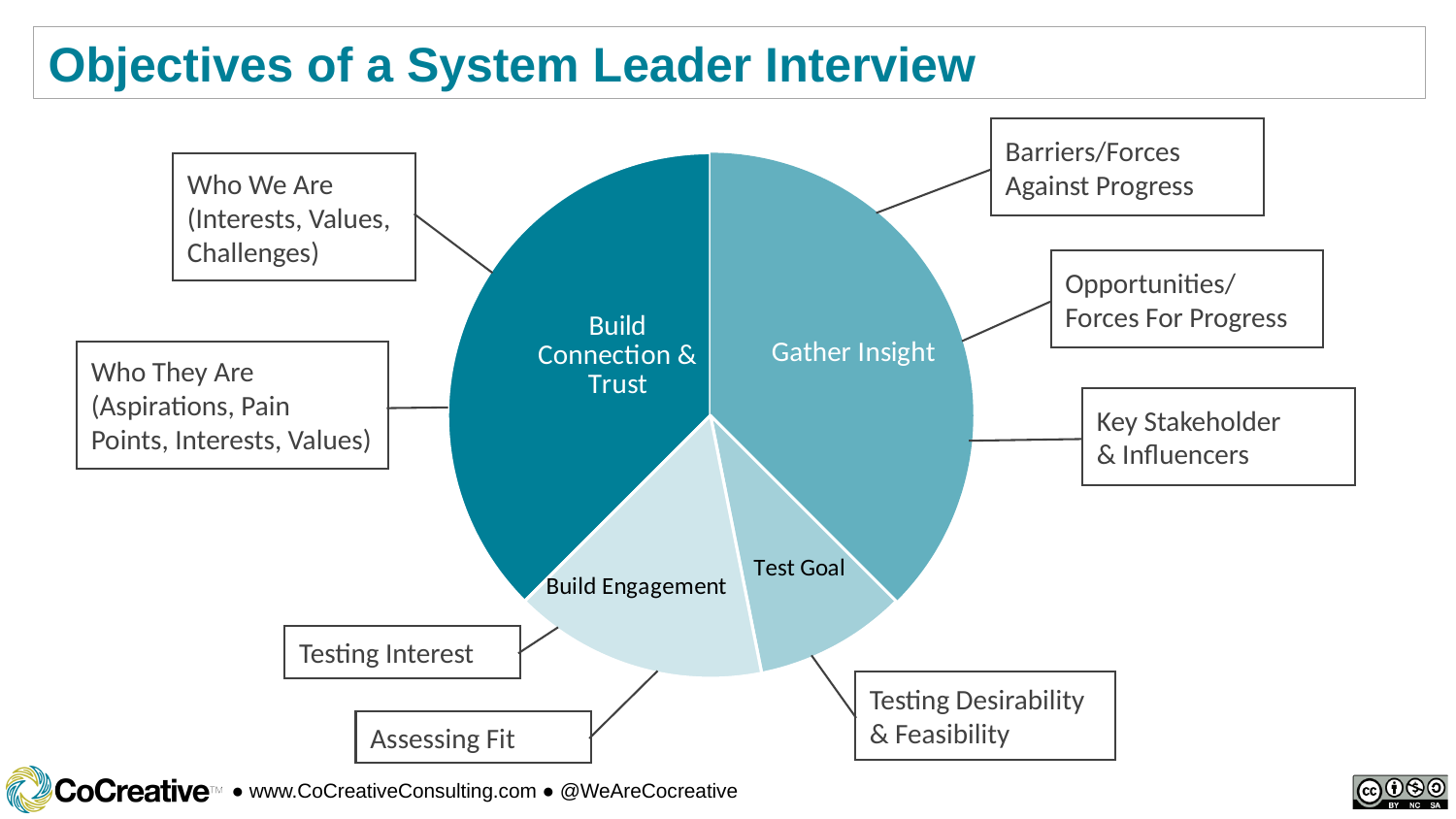
How many slices does the pie chart have? 4 Which slice is larger, Build Connection & Trust or Build Engagement? Build Connection & Trust Which slice is larger, Gather Insight or Build Engagement? Gather Insight Which slice of the pie chart is shown in the darkest teal colour? Build Connection & Trust Which slice of the pie chart is the smallest? Test Goal What kind of chart is shown on the slide? pie chart What is the title of the slide containing the pie chart? Objectives of a System Leader Interview Which slice is larger, Build Engagement or Test Goal? Build Engagement